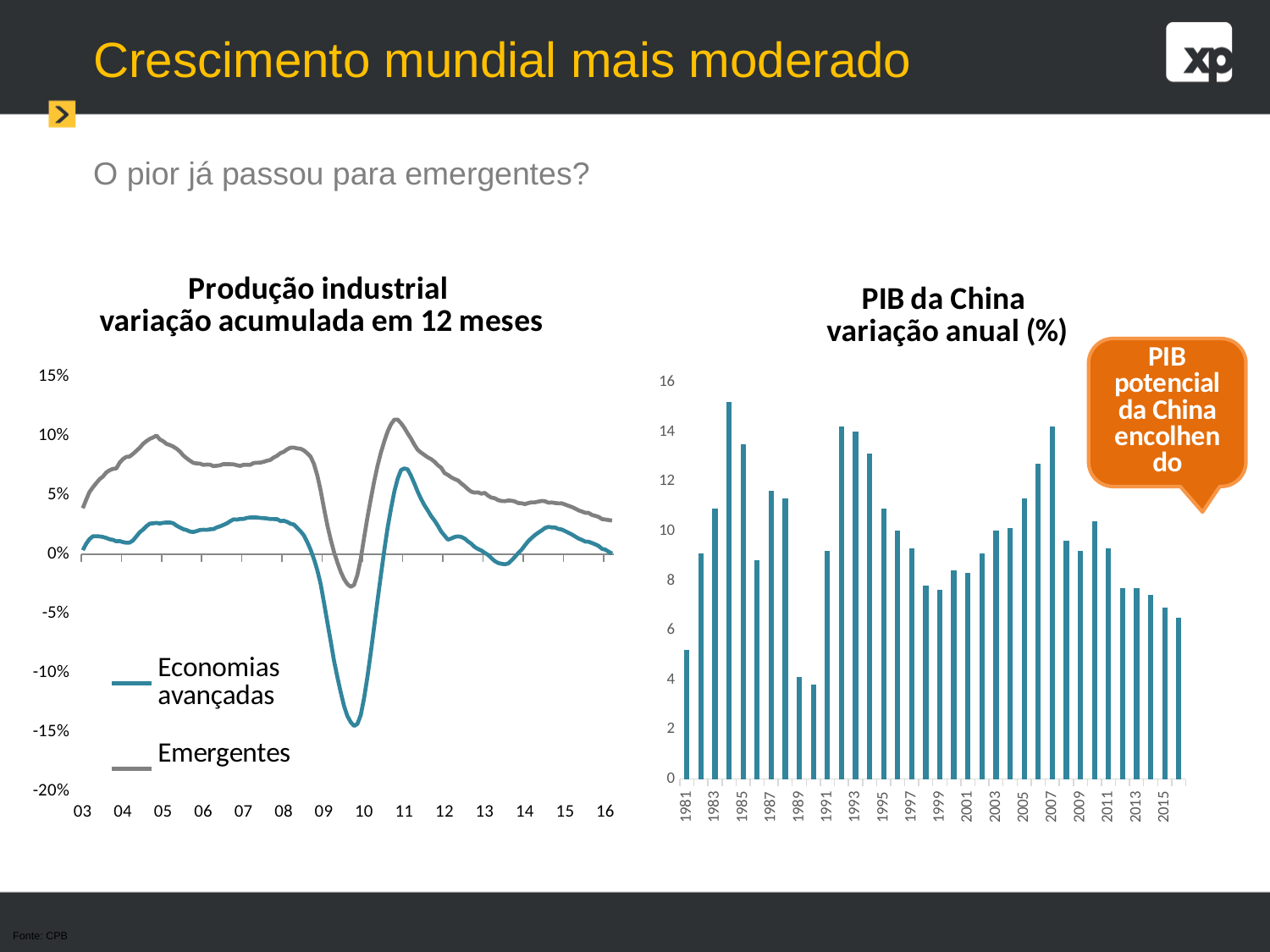
In the 'PIB da China variação anual (%)' chart on the right, do the values rise or fall from 2010 to 2015? fall In the 'Produção industrial' chart on the left, what are the two series named in the legend? Economias avançadas and Emergentes In the 'Produção industrial' chart on the left, how many year labels are shown on the x axis? 14 In the 'PIB da China variação anual (%)' chart on the right, is the value for 2015 greater or less than 8? less What kind of chart is the 'Produção industrial variação acumulada em 12 meses' chart on the left? line chart In the 'PIB da China variação anual (%)' chart on the right, is the value for 1984 greater or less than 14? greater In the 'Produção industrial' chart on the left, how many series does the legend list? 2 In the 'PIB da China variação anual (%)' chart on the right, which year has the highest bar? 1984 In the 'Produção industrial' chart on the left, is the peak of the Emergentes series around 11 greater or less than 10%? greater What kind of chart is the 'PIB da China variação anual (%)' chart on the right? bar chart In the 'Produção industrial' chart on the left, which series is higher in 05, Economias avançadas or Emergentes? Emergentes